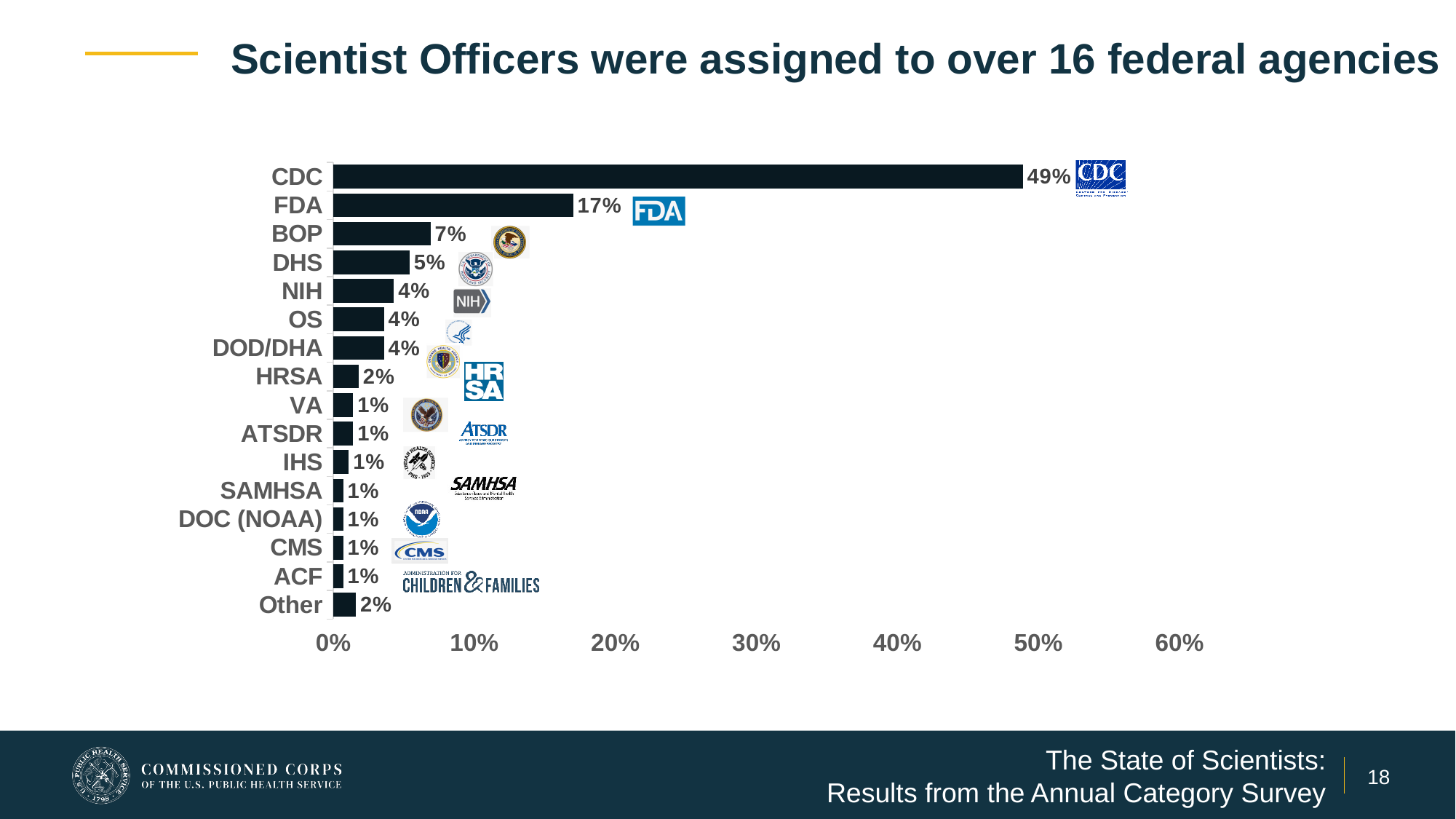
What is the difference in percentage points between CDC and FDA? 32% What is the difference between the values for BOP and DHS? 2% Is the value for CDC greater or less than 40%? greater What is the value shown for BOP? 7% Which has a larger value, FDA or BOP? FDA How many categories (agencies) are shown on the chart? 16 Which agency has the highest percentage of Scientist Officers assigned? CDC What is the value shown for DHS? 5% What percentage of Scientist Officers were assigned to the FDA? 17% What percentage of Scientist Officers were assigned to the CDC? 49% What is the value shown for HRSA? 2% What type of chart is shown on the slide? Bar chart